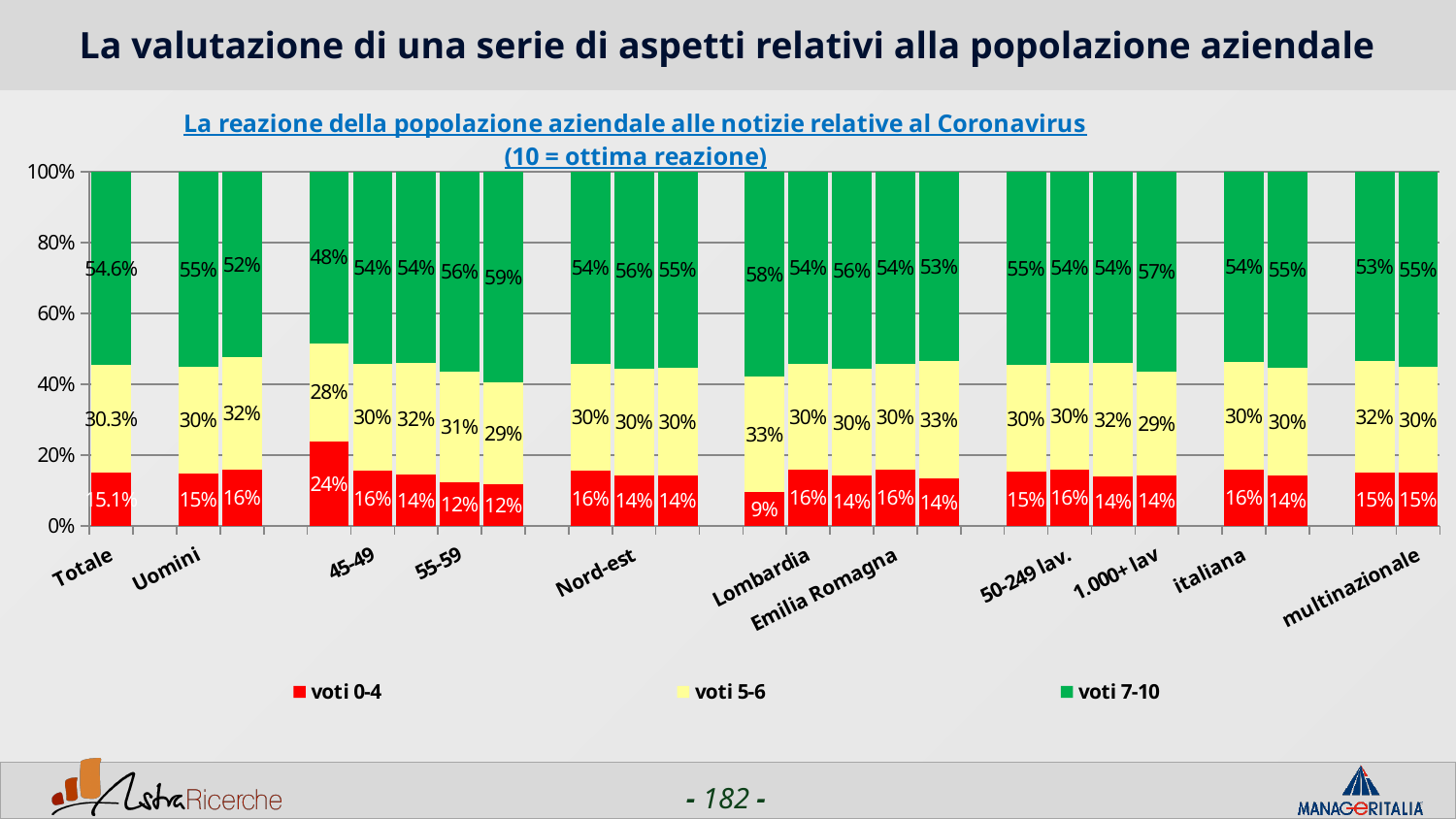
For the 'Totale' bar, which is larger: 'voti 7-10' or 'voti 5-6'? voti 7-10 What is the value of 'voti 7-10' for 'Uomini'? 55% What is the value of 'voti 0-4' for the 'Totale' bar? 15.1% For the 'Totale' bar, what is the difference between 'voti 7-10' and 'voti 5-6'? 24.3 percentage points What kind of chart is shown on the slide? Stacked bar chart What is the value of 'voti 7-10' for the 'Totale' bar? 54.6% How many series does the legend list? 3 What is the value of 'voti 0-4' for 'Uomini'? 15% What are the three legend entries of the chart? voti 0-4, voti 5-6, voti 7-10 What is the value of 'voti 7-10' for '1.000+ lav'? 57% What is the value of 'voti 5-6' for the 'Totale' bar? 30.3% Is the 'voti 7-10' value for 'Totale' greater or less than 40%? greater